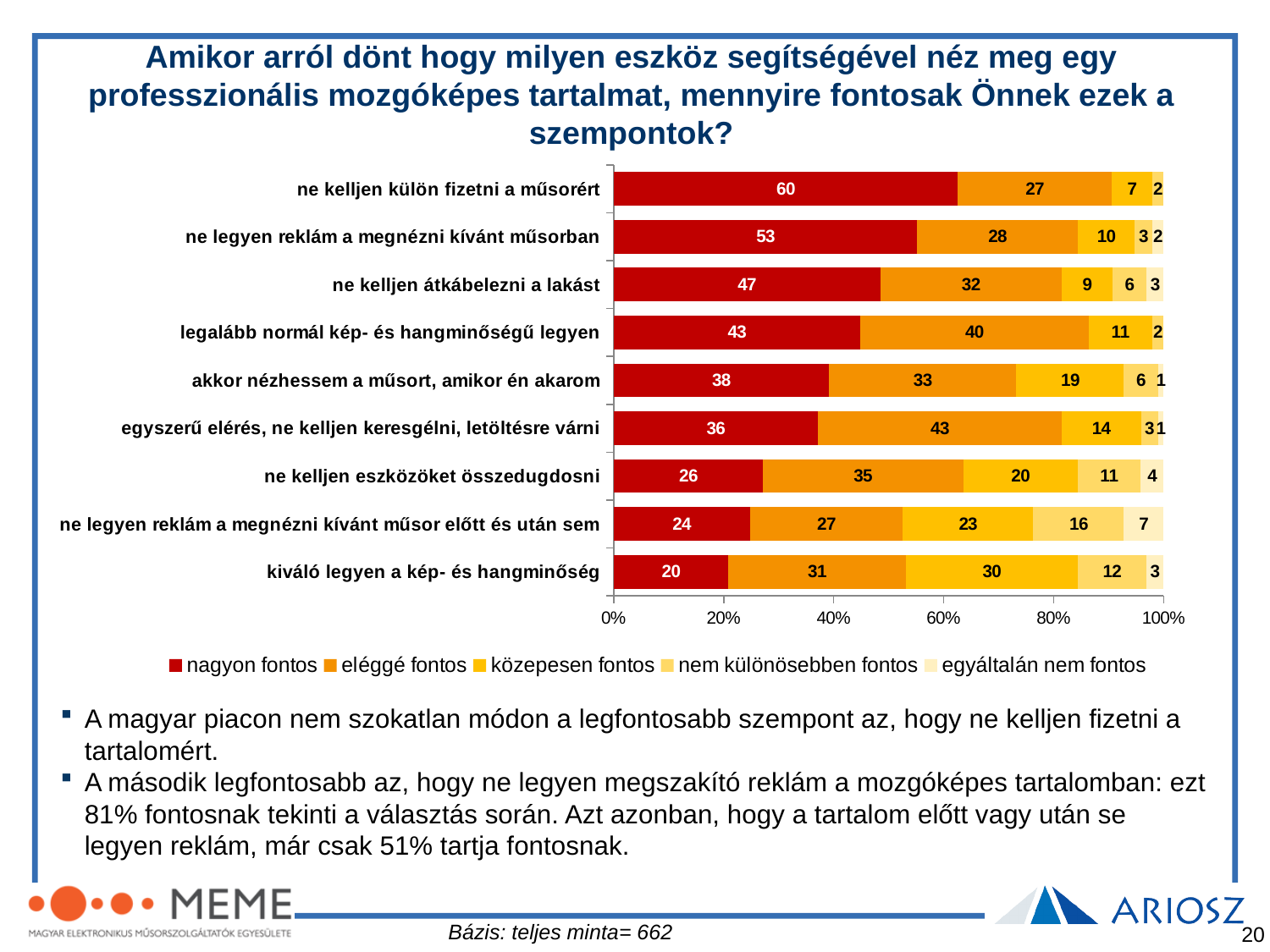
What is the first series listed in the legend? nagyon fontos Which category has the lowest 'nagyon fontos' value? kiváló legyen a kép- és hangminőség Which has a larger 'eléggé fontos' value: 'egyszerű elérés, ne kelljen keresgélni, letöltésre várni' or 'ne kelljen eszközöket összedugdosni'? egyszerű elérés, ne kelljen keresgélni, letöltésre várni Which category has the highest 'nagyon fontos' value? ne kelljen külön fizetni a műsorért What is the 'egyáltalán nem fontos' value for 'ne legyen reklám a megnézni kívánt műsor előtt és után sem'? 7 How many categories (statements) are plotted on the chart? 9 What is the difference between the 'nagyon fontos' values for 'ne kelljen külön fizetni a műsorért' and 'ne legyen reklám a megnézni kívánt műsorban'? 7 What is the 'közepesen fontos' value for 'kiváló legyen a kép- és hangminőség'? 30 What is the 'nagyon fontos' value for 'ne kelljen külön fizetni a műsorért'? 60 What is the 'eléggé fontos' value for 'legalább normál kép- és hangminőségű legyen'? 40 What kind of chart is shown on the slide? stacked bar chart How many series does the legend list? 5